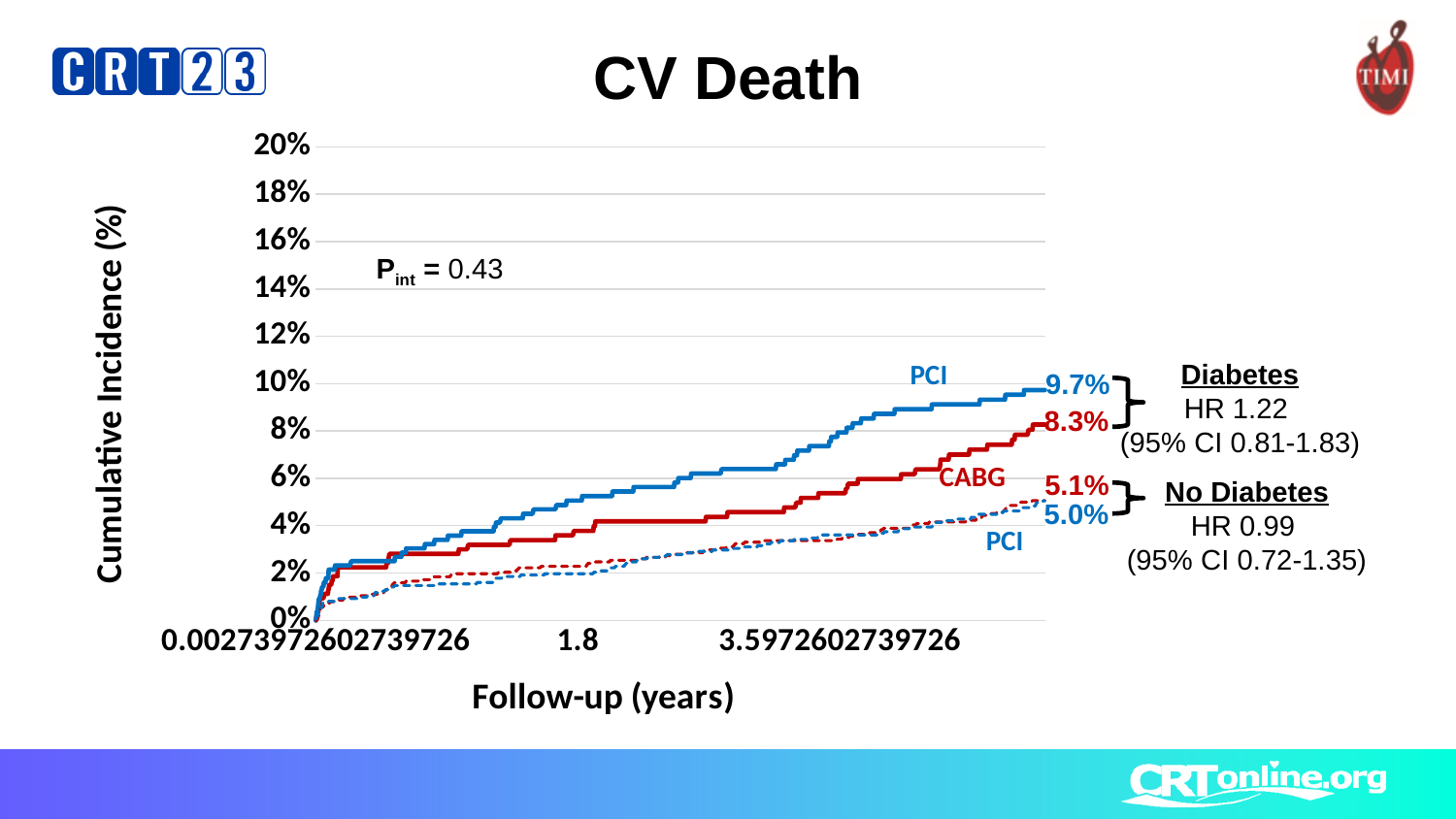
What is the 95% confidence interval reported for the No Diabetes group? 0.72-1.35 In the Diabetes group, which has the larger final cumulative incidence, PCI or CABG? PCI What is the final cumulative incidence of CV death for CABG in the No Diabetes group? 5.1% What is the title of the chart? CV Death What is the difference between the final PCI and CABG cumulative incidence values in the Diabetes group? 1.4% Which curve reaches the highest final cumulative incidence? PCI (Diabetes) What type of chart is shown on the slide? Line chart What is the label of the y-axis? Cumulative Incidence (%) What is the hazard ratio reported for the Diabetes group? HR 1.22 What is the final cumulative incidence of CV death for PCI in the No Diabetes group? 5.0% What is the final cumulative incidence of CV death for CABG in the Diabetes group? 8.3% What is the final cumulative incidence of CV death for PCI in the Diabetes group? 9.7%